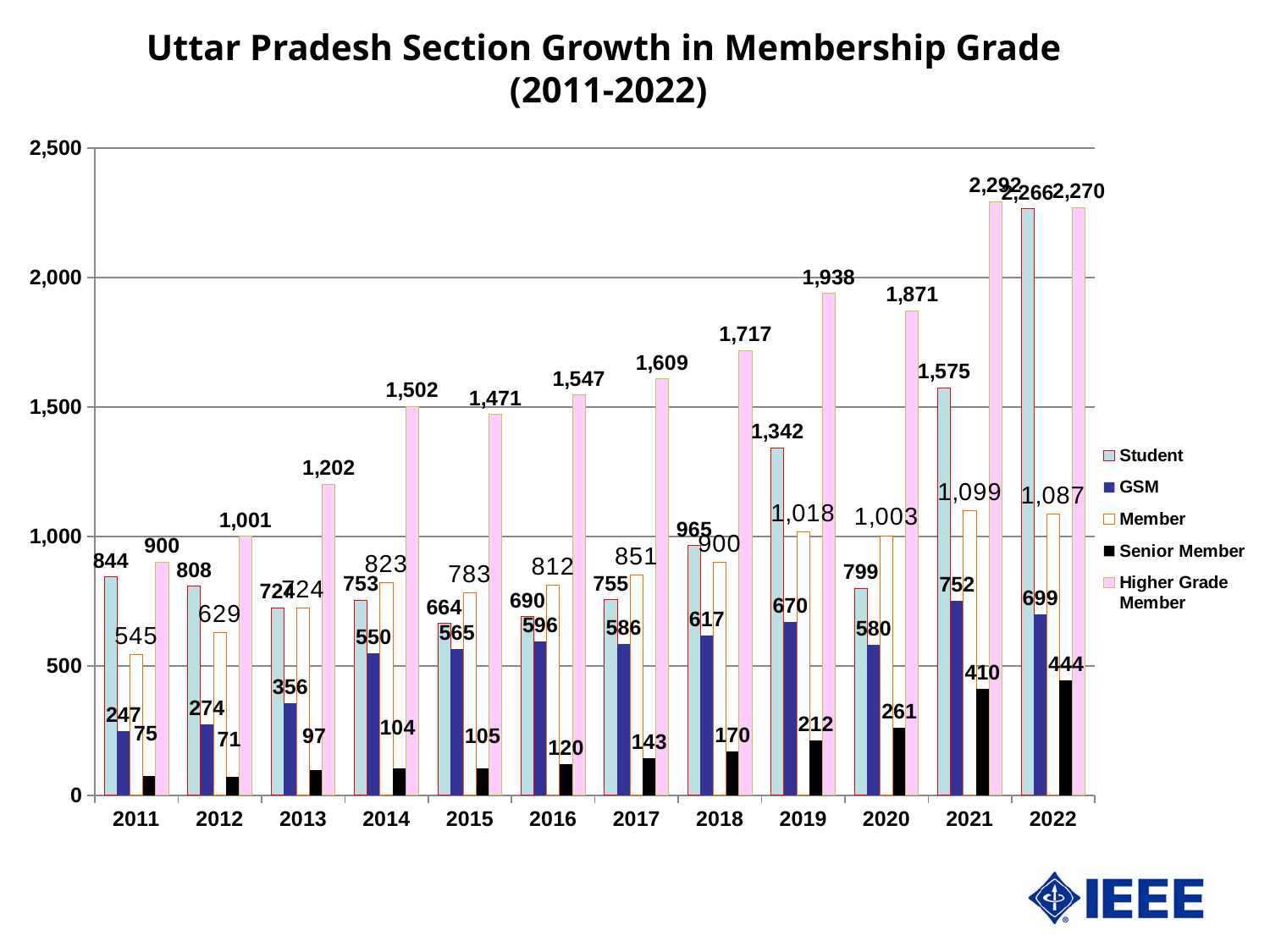
What is the Higher Grade Member value for 2018? 1,717 How many years are shown along the x axis? 12 Do the Senior Member values generally rise or fall from 2011 to 2022? rise What is the GSM value for 2014? 550 What is the difference between the Senior Member values for 2020 and 2019? 49 What is the Senior Member value for 2019? 212 In which year is the GSM value lowest? 2011 How many series does the legend list? 5 In which year is the Senior Member value highest? 2022 Which year has the larger GSM value, 2021 or 2022? 2021 What kind of chart is shown on the slide? bar chart Is the Student value for 2021 greater or less than 1,500? greater